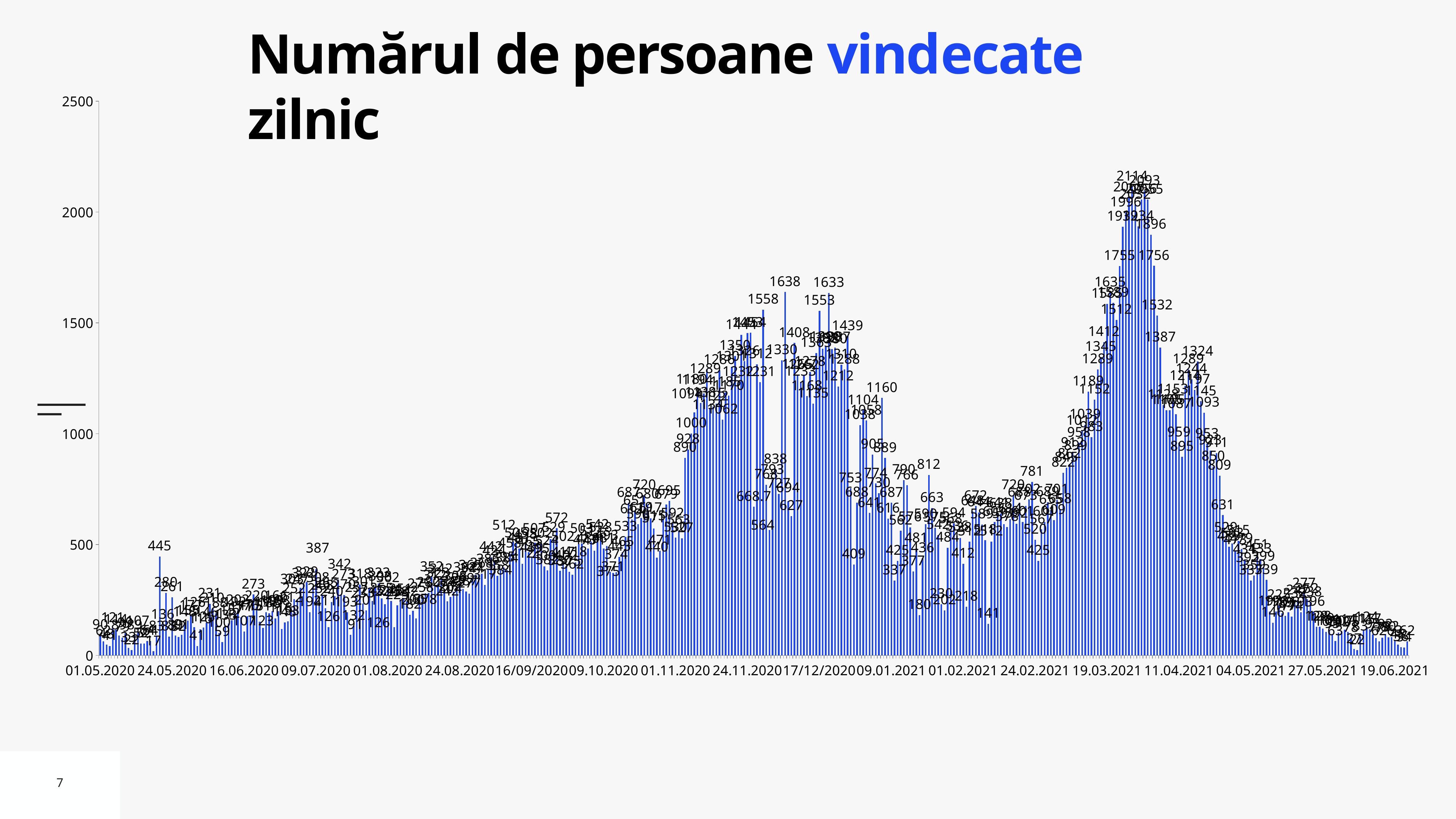
Is the value for 01.05.2020 greater or less than 500? less What is the last date label on the horizontal axis? 19.06.2021 What is the title of the chart? Numărul de persoane vindecate zilnic Is the highest bar near 11.04.2021 greater or less than 2000? greater What is the difference between the labelled values 445 and 387 in the first part of the chart? 58 What is the highest value shown on the vertical axis? 2500 What is the difference between the peak value of 2114 and the November 2020 peak of 1638? 476 Which is larger: the peak value in April 2021 (2114) or the peak value in November 2020 (1638)? 2114 What is the highest daily value labelled on the chart? 2114 What is the first date label on the horizontal axis? 01.05.2020 What kind of chart is shown on the slide? bar chart How many date labels are shown on the horizontal axis? 19